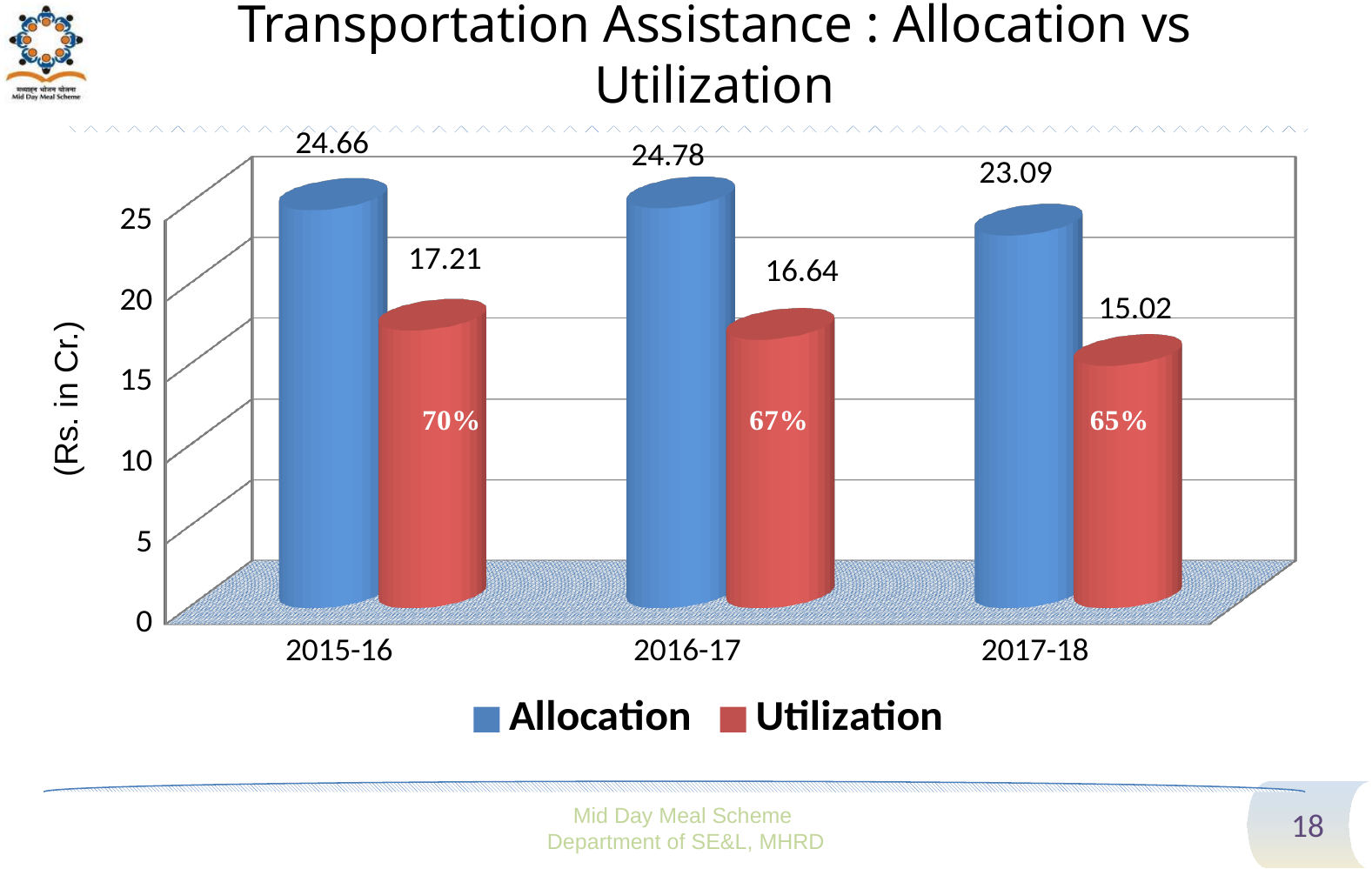
What percentage label is printed on the Utilization bar for 2016-17? 67% Which year has the lowest Utilization? 2017-18 Which is larger, the Utilization for 2015-16 or the Utilization for 2017-18? 2015-16 What is the difference between Allocation and Utilization in 2015-16? 7.45 What is the Utilization value for 2017-18? 15.02 Which year has the highest Allocation? 2016-17 What is the Allocation value for 2015-16? 24.66 Does the Utilization series rise or fall from 2015-16 to 2017-18? Fall What kind of chart is shown on the slide? Bar chart How many series does the legend list? 2 What is the Utilization value for 2016-17? 16.64 How many years are shown on the x axis? 3